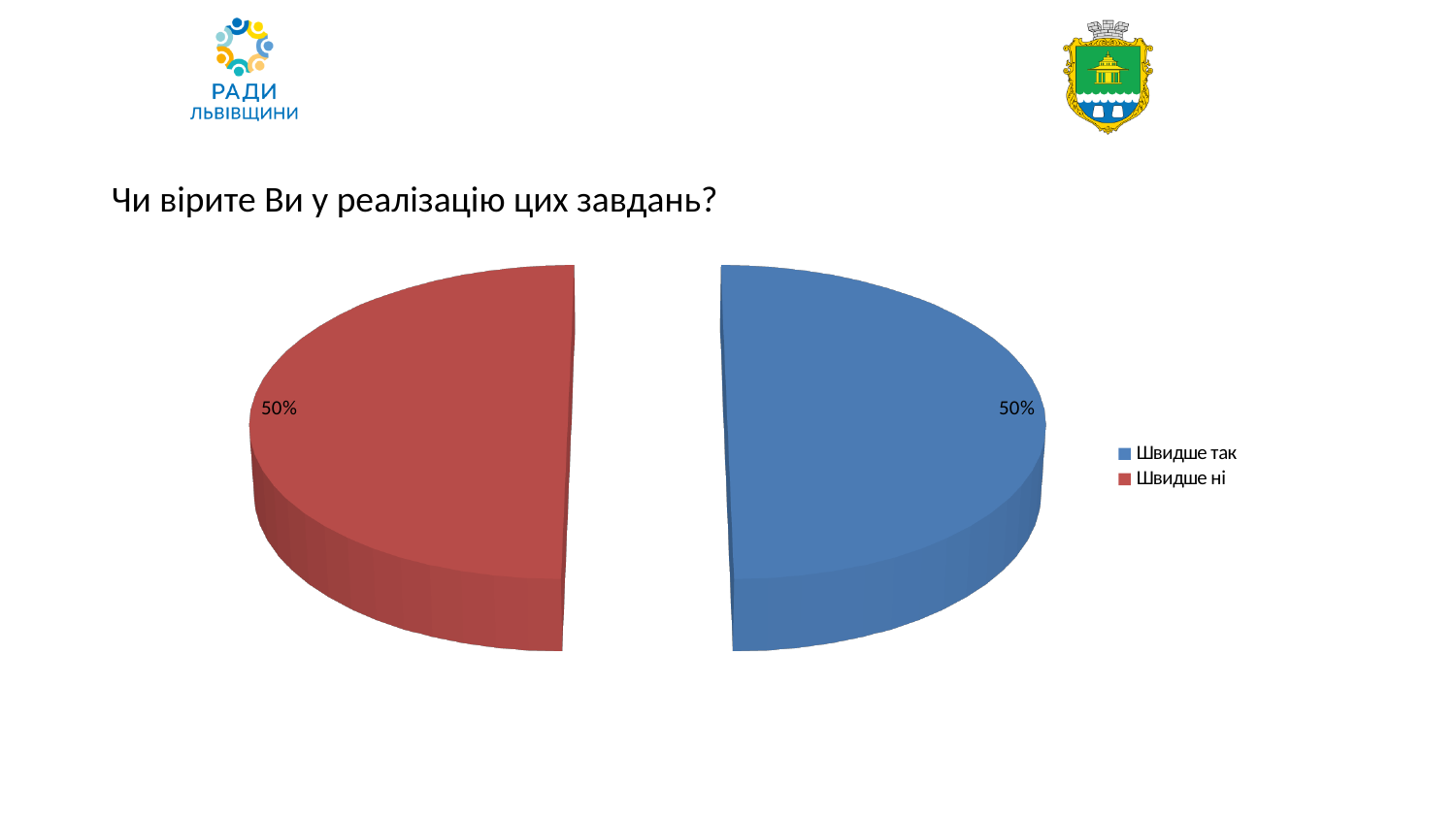
What share of the pie does "Швидше ні" represent? 50% How many slices does the pie chart have? 2 What is the value shown for the "Швидше так" slice? 50% Which colour represents "Швидше ні" in the pie chart? Red What kind of chart is shown on the slide? Pie chart How many entries does the legend list? 2 What share of the pie does "Швидше так" represent? 50% What question is the chart on the slide answering? Чи вірите Ви у реалізацію цих завдань? What is the value shown for the "Швидше ні" slice? 50% What is the difference between the "Швидше так" and "Швидше ні" shares? 0% What is the combined share of the "Швидше так" and "Швидше ні" slices? 100%